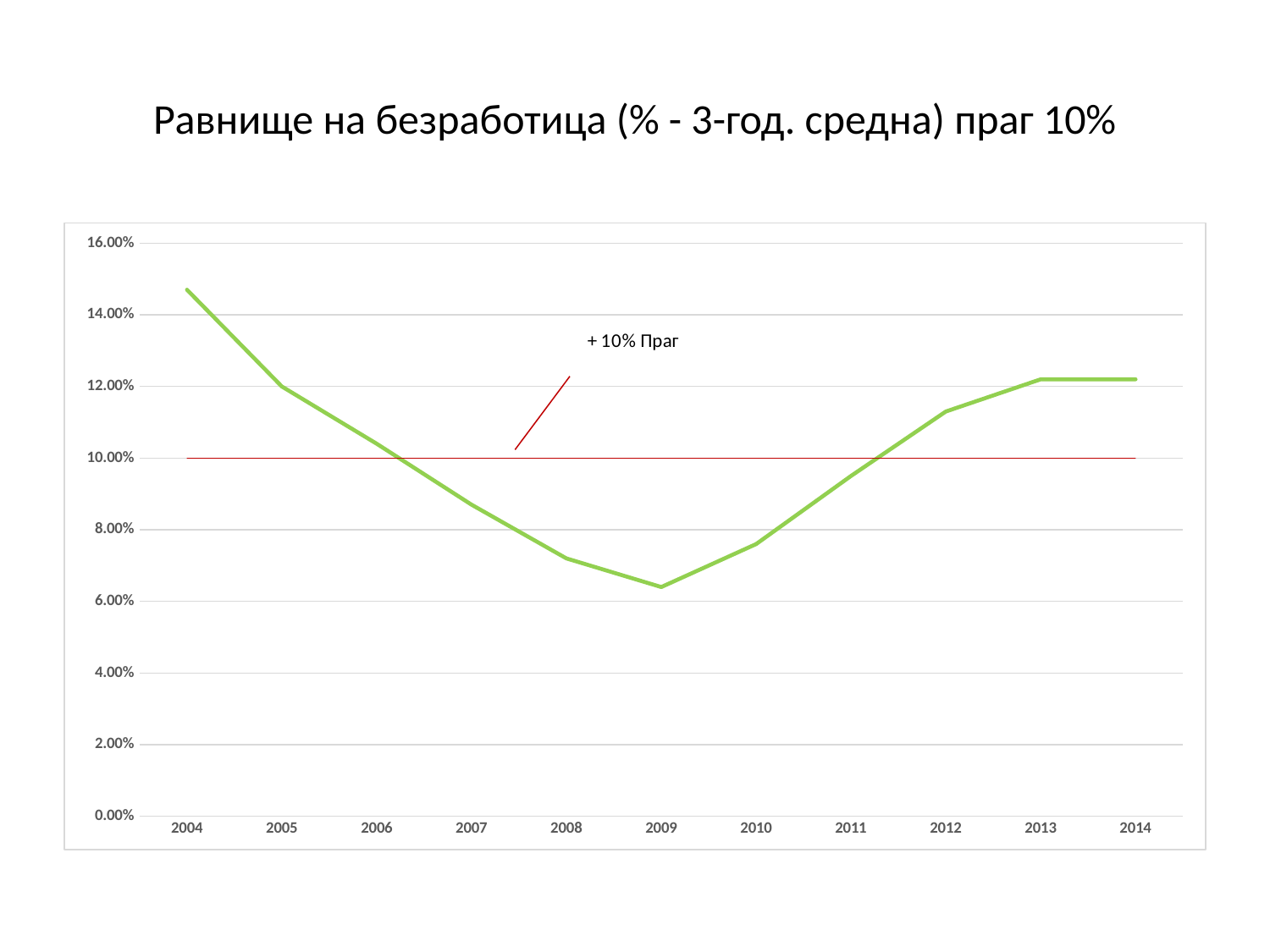
Which year has the highest unemployment rate? 2004 Does the unemployment rate rise or fall from 2004 to 2009? fall Is the value for 2012 greater or less than 10.00%? greater What kind of chart is shown on the slide? line chart Is the value for 2011 greater or less than 10.00%? less Which year has the lowest unemployment rate? 2009 How many years are plotted along the x axis? 11 Which year has a higher unemployment rate, 2004 or 2014? 2004 What is the label of the horizontal threshold line marked on the chart? + 10% Праг Which year has a higher unemployment rate, 2009 or 2010? 2010 Is the value for 2008 greater or less than 8.00%? less